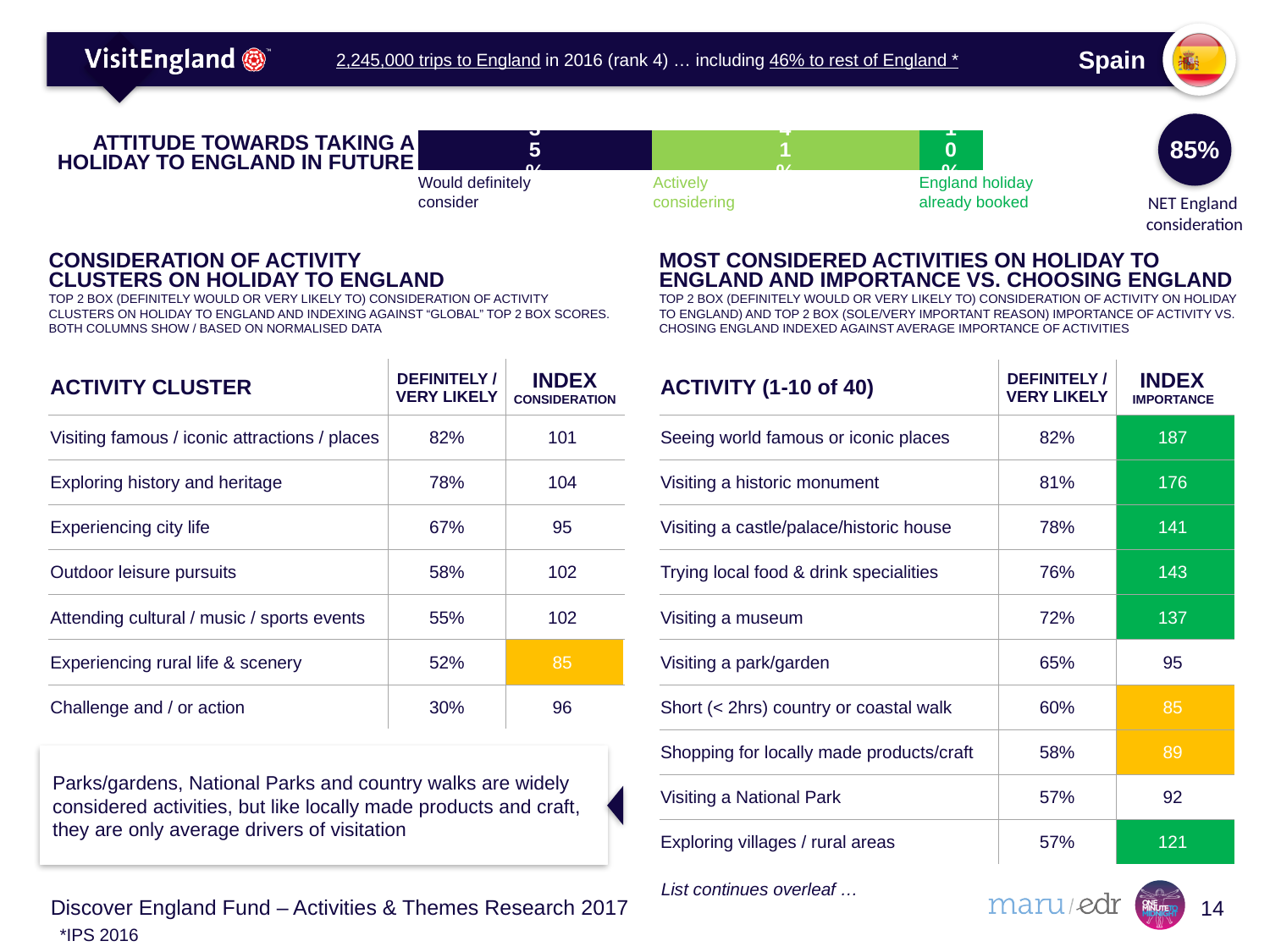
What colour is the 'Actively considering' segment of the attitude bar? green What kind of chart is used for 'Attitude towards taking a holiday to England in future'? bar chart In the 'Attitude towards taking a holiday to England in future' bar, which segment is the smallest? England holiday already booked What value is shown for 'Would definitely consider' in the attitude bar? 35% In the 'Most considered activities' table, what is the index importance for 'Seeing world famous or iconic places'? 187 How many segments does the 'Attitude towards taking a holiday to England in future' bar have? 3 What is the NET England consideration figure shown next to the attitude bar? 85% What colour is the 'Would definitely consider' segment of the attitude bar? dark navy blue In the 'Attitude towards taking a holiday to England in future' bar, which is larger: 'Would definitely consider' or 'England holiday already booked'? Would definitely consider What value is shown for 'Actively considering' in the attitude bar? 41% In the 'Attitude towards taking a holiday to England in future' bar, which segment is the largest? Actively considering What value is shown for 'England holiday already booked' in the attitude bar? 10%